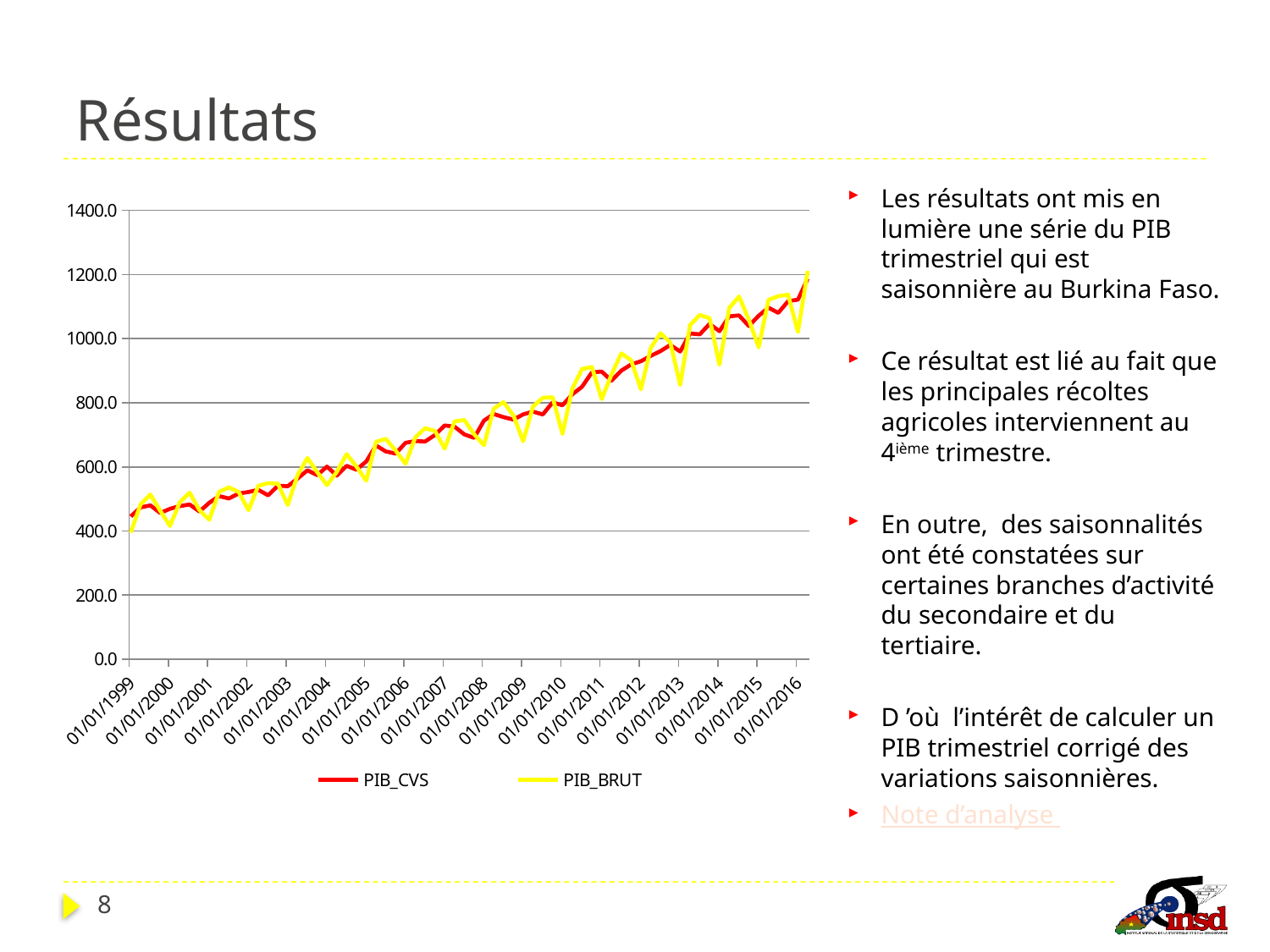
Is the value of PIB_CVS at 01/01/1999 greater or less than 600? less What are the names of the two series in the chart legend? PIB_CVS and PIB_BRUT Is the value of PIB_CVS at 01/01/2008 greater or less than 800? less Which colour is used for the PIB_BRUT series? yellow What kind of chart is shown on the slide? line chart What is the highest value shown on the y axis? 1400.0 How many year labels are shown on the x axis? 18 Is the value of PIB_CVS at 01/01/2008 greater or less than 600? greater Do the values of PIB_CVS rise or fall overall from 01/01/1999 to 01/01/2016? rise How many series does the chart legend list? 2